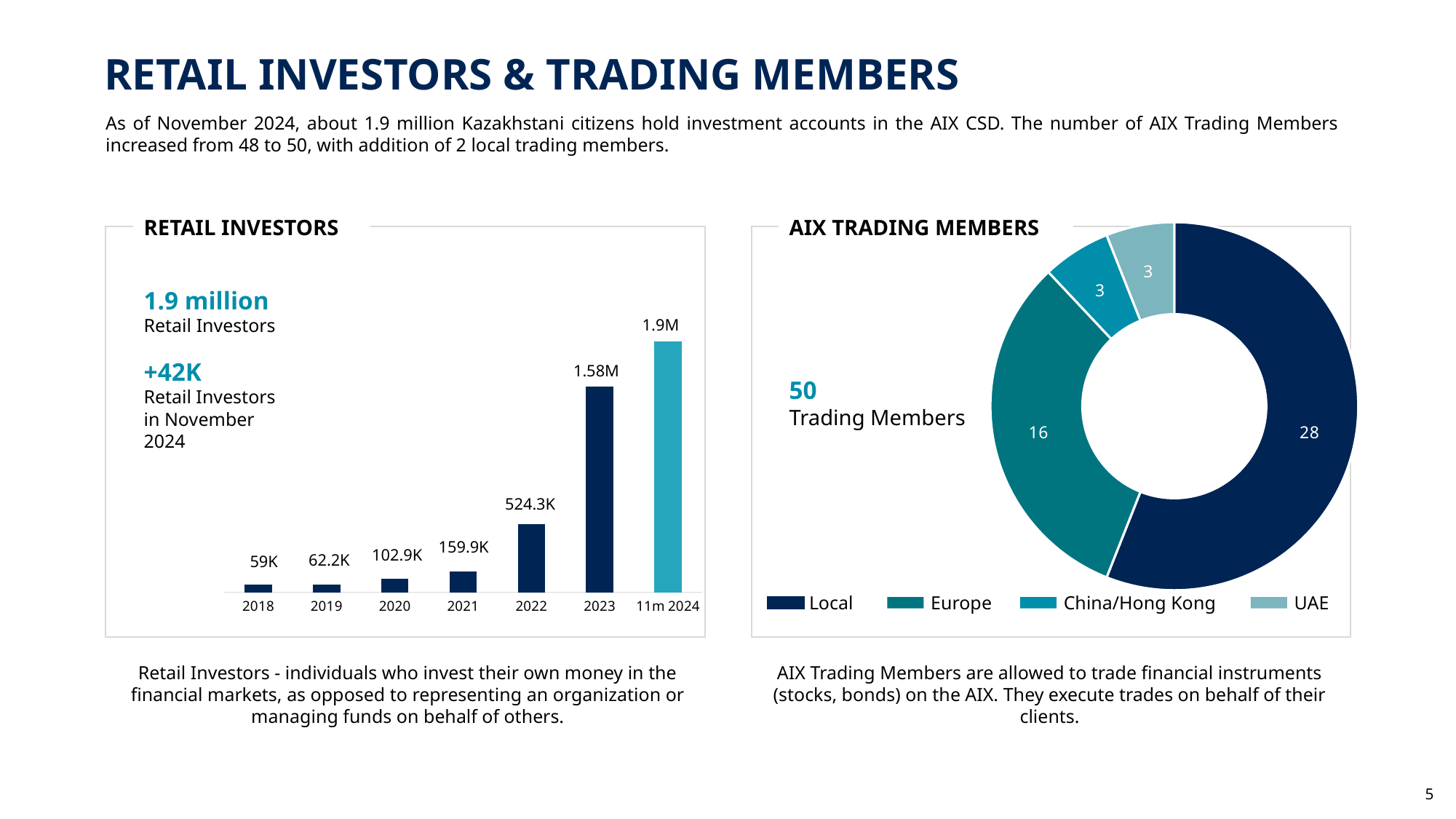
In the RETAIL INVESTORS chart, do the values rise or fall from 2018 to 11m 2024? rise In the AIX TRADING MEMBERS chart, what is the difference between Local and Europe? 12 In the AIX TRADING MEMBERS chart, which category has the largest value? Local In the RETAIL INVESTORS chart, which category has the highest value? 11m 2024 In the RETAIL INVESTORS chart, how many bars are plotted? 7 In the RETAIL INVESTORS chart, which year has the lowest value? 2018 In the RETAIL INVESTORS chart, what is the value for 2020? 102.9K In the RETAIL INVESTORS chart, what is the value for 2022? 524.3K What kind of chart is the RETAIL INVESTORS chart? bar chart In the AIX TRADING MEMBERS chart, what is the value for Europe? 16 How many entries does the legend of the AIX TRADING MEMBERS chart list? 4